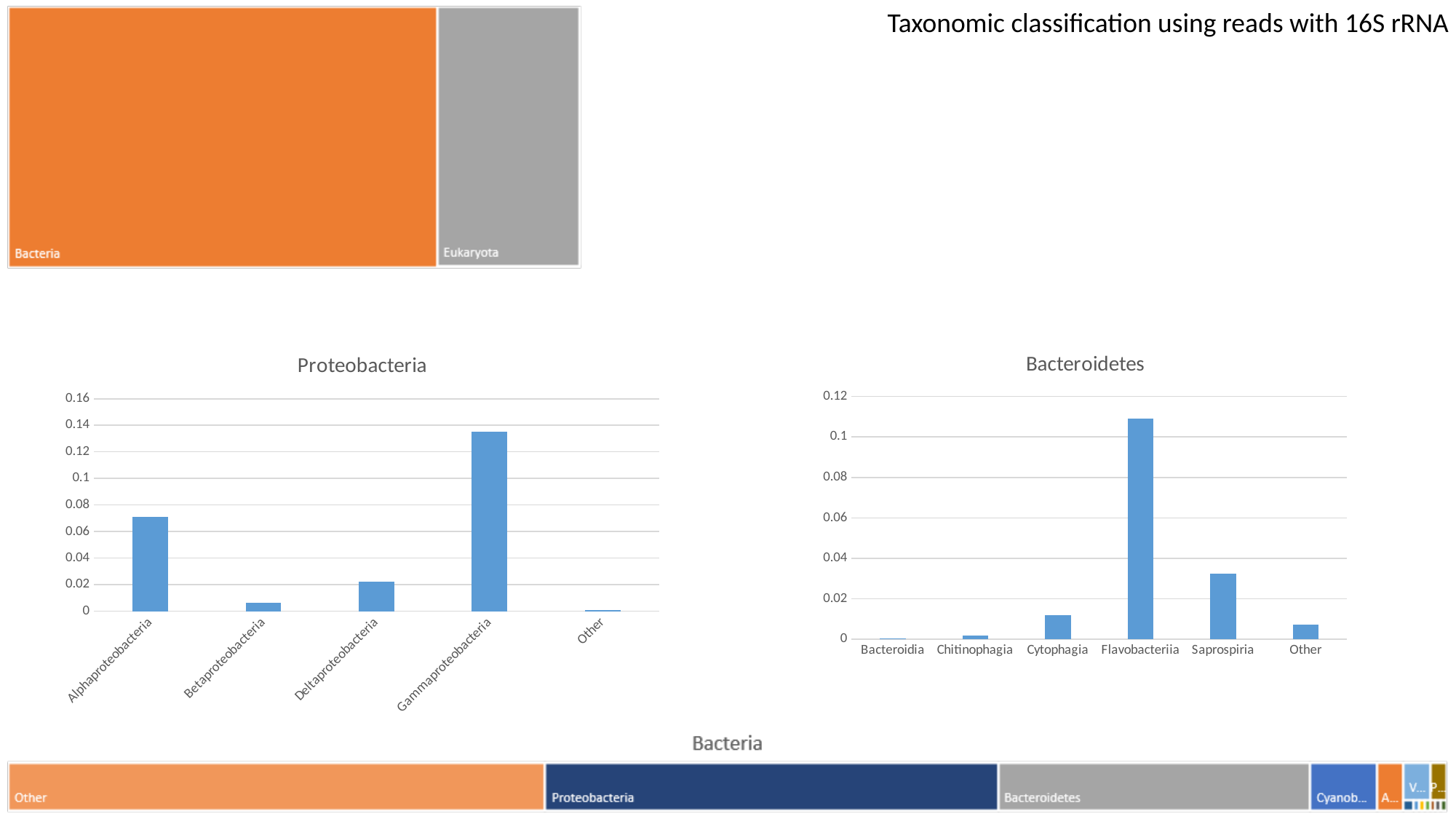
How many categories are shown on the x axis of the Bacteroidetes chart? 6 In the Bacteroidetes chart, which is larger, Saprospiria or Cytophagia? Saprospiria How many categories are shown on the x axis of the Proteobacteria chart? 5 In the Proteobacteria chart, which category has the lowest value? Other In the Proteobacteria chart, which is larger, Alphaproteobacteria or Deltaproteobacteria? Alphaproteobacteria In the Proteobacteria chart, is the value for Alphaproteobacteria greater or less than 0.08? less In the Bacteroidetes chart, is the value for Saprospiria greater or less than 0.04? less In the Proteobacteria chart, which category has the highest value? Gammaproteobacteria In the Bacteroidetes chart, which category has the highest value? Flavobacteriia What kind of chart is the Bacteroidetes chart? bar chart In the Bacteroidetes chart, is the value for Flavobacteriia greater or less than 0.1? greater